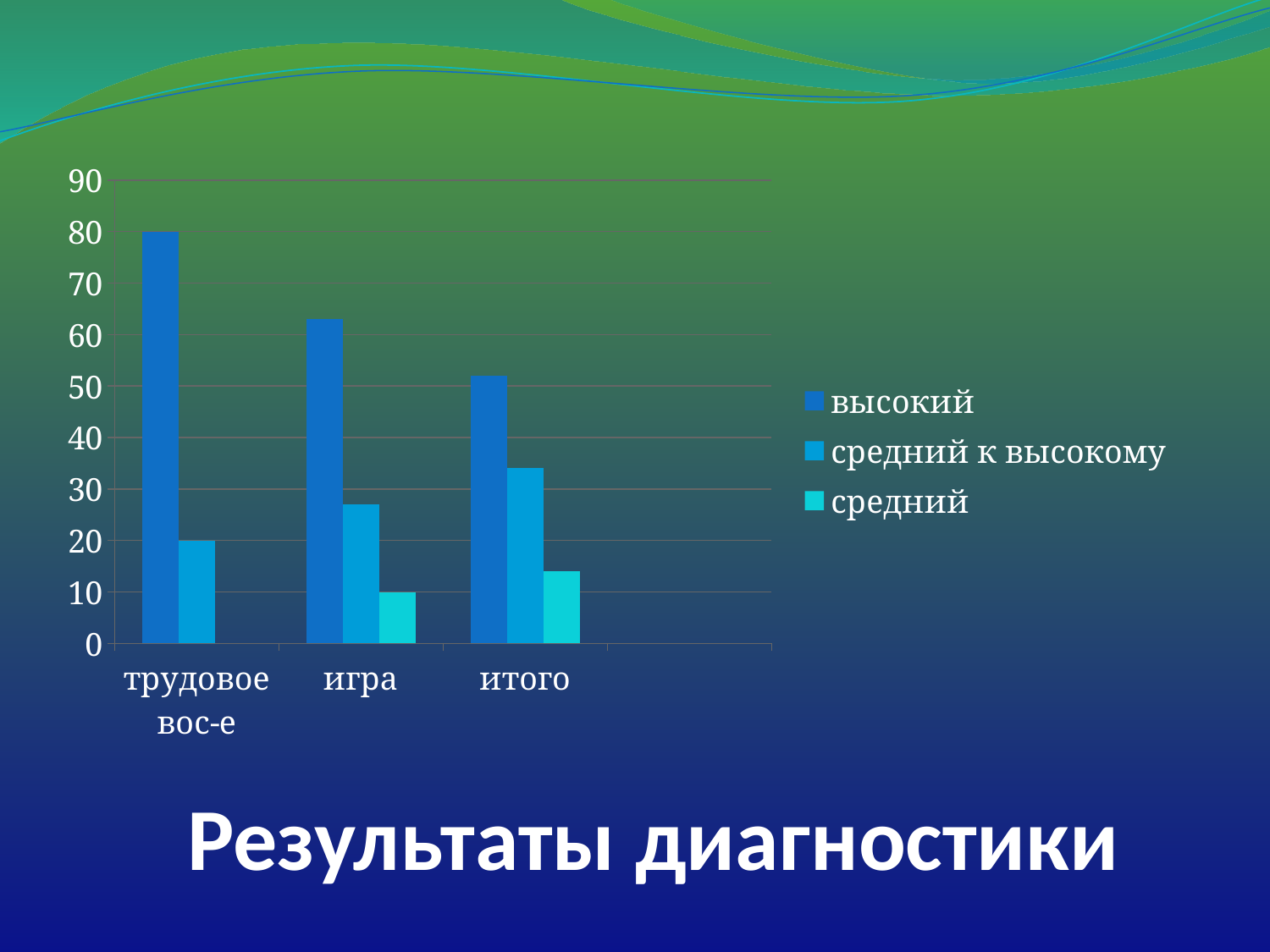
What kind of chart is shown on the slide? bar chart Does the высокий series rise or fall from трудовое вос-е to итого? fall How many series does the legend list? 3 Which category has the highest value for the высокий series? трудовое вос-е Is the value of the средний к высокому series for итого greater or less than 30? greater What is the value of the средний к высокому series for трудовое вос-е? 20 What is the value of the высокий series for трудовое вос-е? 80 How many categories are shown on the x axis? 3 Which category has the lowest value for the высокий series? итого Is the value of the высокий series for игра greater or less than 60? greater Which is larger for итого: the высокий series or the средний series? высокий What is the value of the средний series for игра? 10